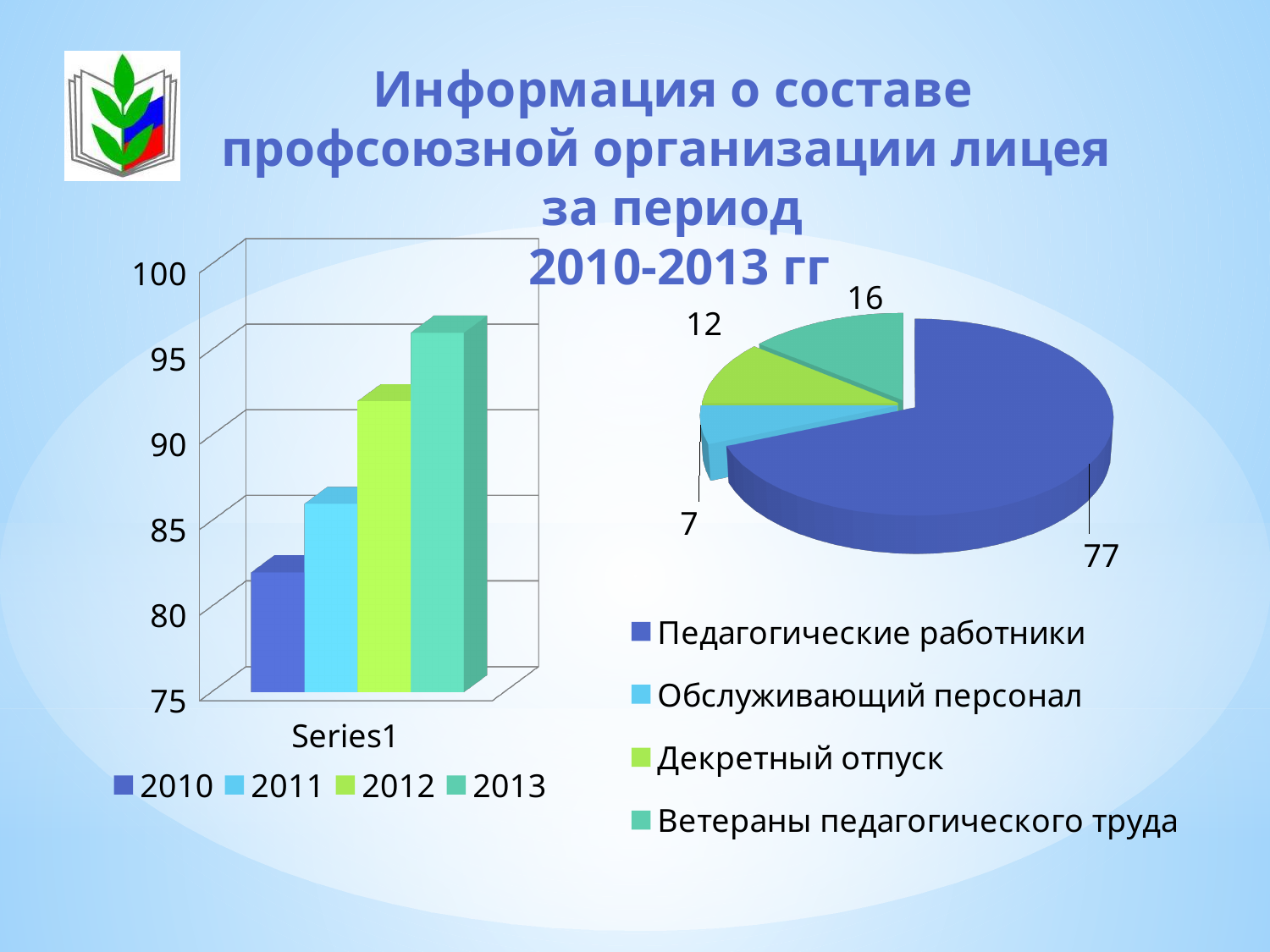
What type of chart is on the right side of the slide? pie chart In the right pie chart, what is the difference between Ветераны педагогического труда and Декретный отпуск? 4 In the left bar chart, is the value for 2012 greater or less than 90? greater What type of chart is on the left side of the slide? bar chart In the left bar chart, which year has the highest bar? 2013 In the left bar chart, do the bars rise or fall from 2010 to 2013? rise In the right pie chart, which category has the smallest slice? Обслуживающий персонал In the left bar chart, how many series does the legend list? 4 In the right pie chart, what is the value for Педагогические работники? 77 In the left bar chart, is the value for 2011 greater or less than 90? less In the left bar chart, is the value for 2010 greater or less than 85? less In the right pie chart, what is the value for Обслуживающий персонал? 7